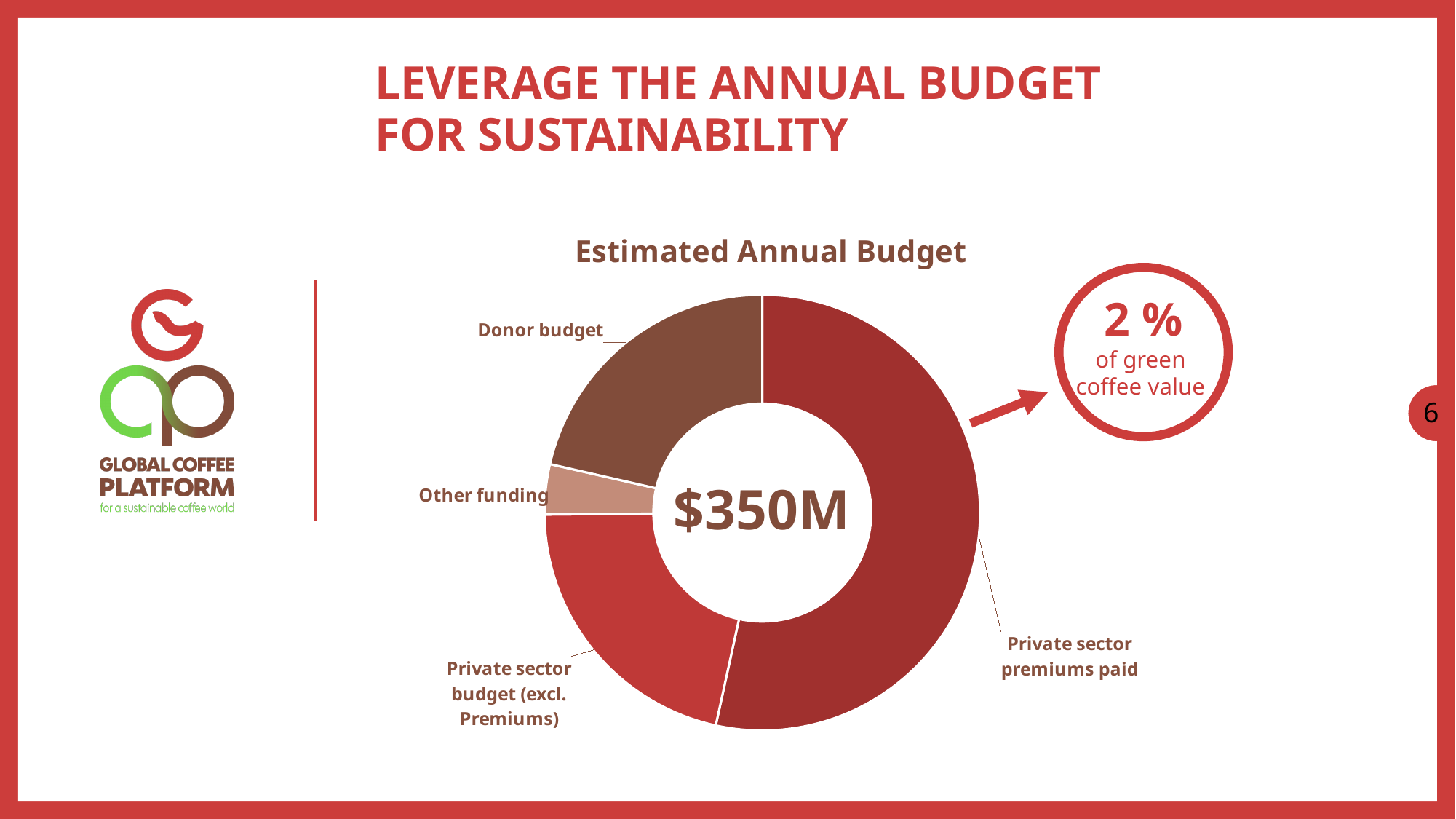
How many categories (slices) does the chart have? 4 Is the Other funding slice greater or less than 10% of the chart? less Which category has the largest slice of the chart? Private sector premiums paid What kind of chart is shown on the slide? Pie (donut) chart According to the callout next to the chart, the estimated annual budget equals what percentage of green coffee value? 2 % Which slice is larger: Private sector premiums paid or Private sector budget (excl. Premiums)? Private sector premiums paid Which slice is larger: Donor budget or Other funding? Donor budget What is the title of the chart? Estimated Annual Budget What total value is printed in the centre of the donut chart? $350M Which category has the smallest slice of the chart? Other funding Is the Private sector premiums paid slice greater or less than 25% of the chart? greater